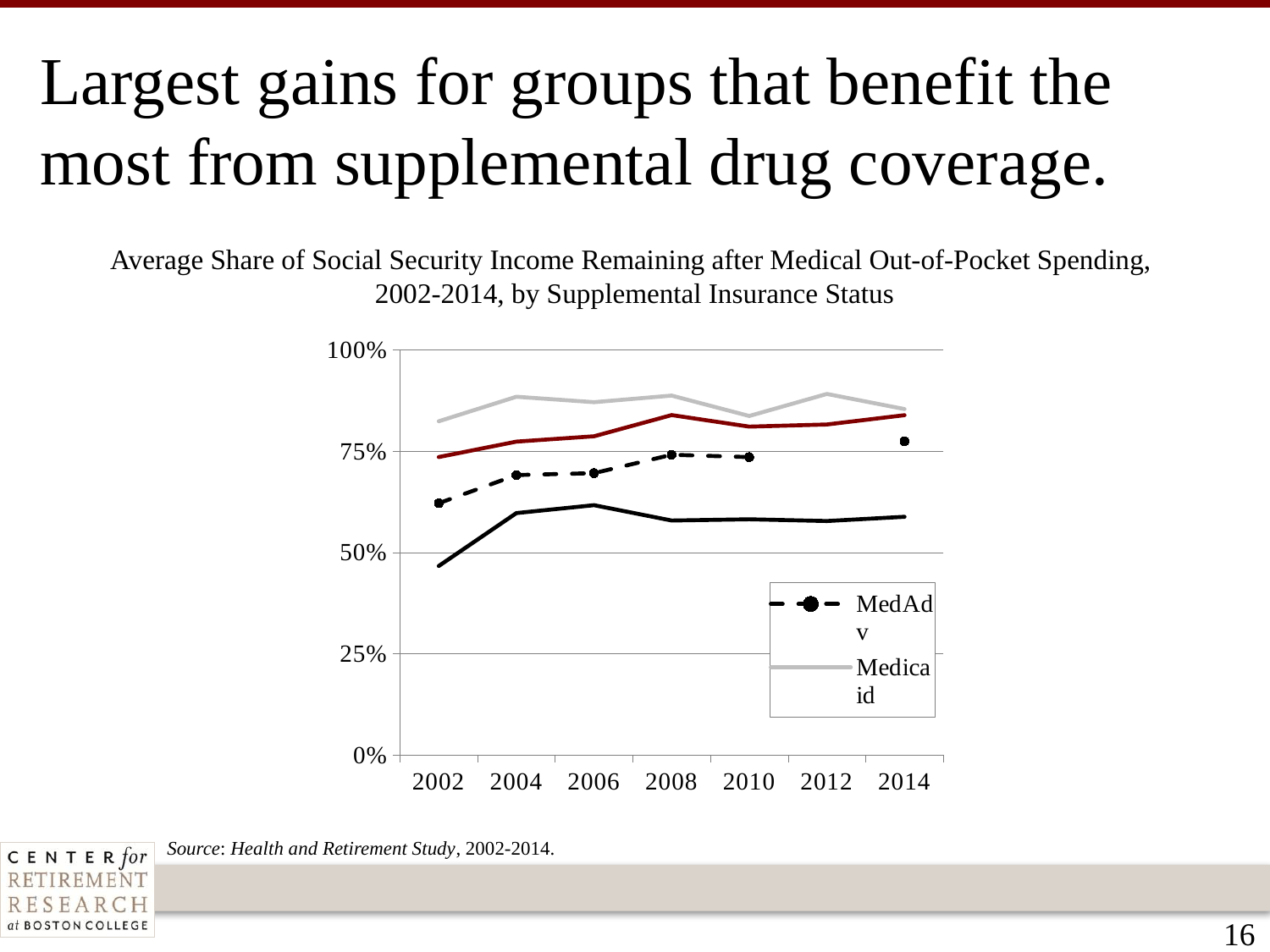
Is the value for Medicaid in 2002 greater or less than 75%? greater Is the value for MedAdv in 2002 greater or less than 75%? less Is the value for MedAdv in 2002 greater or less than 50%? greater How many years are labeled along the x axis of the chart? 7 What is the first year shown on the x axis of the chart? 2002 In 2002, which is larger: the value for Medicaid or the value for MedAdv? Medicaid Which of the two legend series has the higher values across the chart? Medicaid How many series does the chart's legend list? 2 Does the MedAdv line generally rise or fall from 2002 to 2014? rise What kind of chart is shown on the slide? line chart